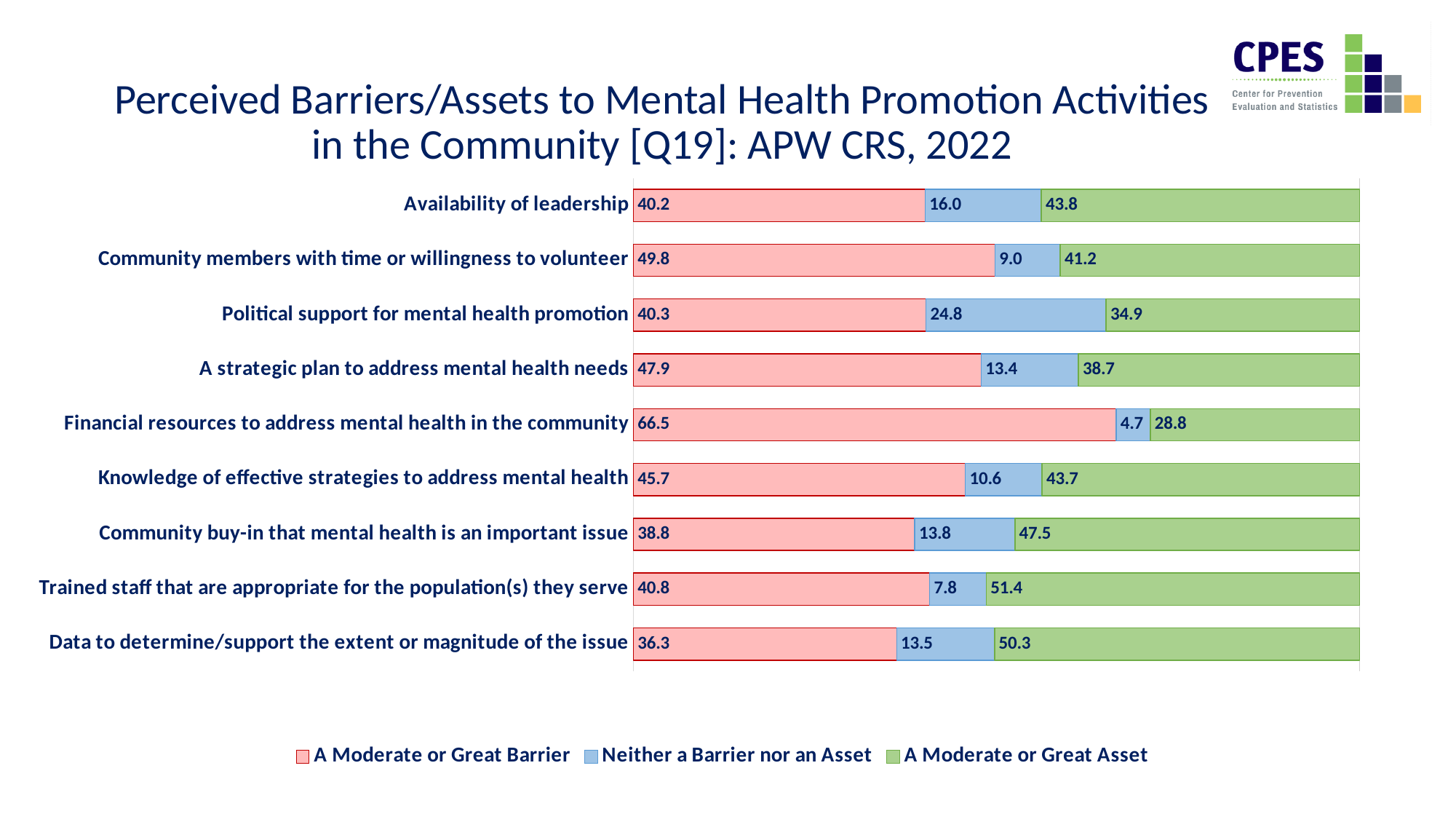
Which category has the lowest value for 'A Moderate or Great Barrier'? Data to determine/support the extent or magnitude of the issue How many series does the legend list? 3 Which category has the lowest value for 'Neither a Barrier nor an Asset'? Financial resources to address mental health in the community Which is larger: the 'A Moderate or Great Barrier' value for Community members with time or willingness to volunteer or for A strategic plan to address mental health needs? Community members with time or willingness to volunteer What is the value for 'Neither a Barrier nor an Asset' for Political support for mental health promotion? 24.8 Which category has the highest value for 'A Moderate or Great Barrier'? Financial resources to address mental health in the community What is the difference between the 'A Moderate or Great Asset' values for Trained staff that are appropriate for the population(s) they serve and Political support for mental health promotion? 16.5 What is the value for 'A Moderate or Great Asset' for Trained staff that are appropriate for the population(s) they serve? 51.4 What is the value for 'A Moderate or Great Barrier' for Financial resources to address mental health in the community? 66.5 How many categories are shown on the chart? 9 Which colour represents 'A Moderate or Great Asset' in the chart? Green What kind of chart is shown on the slide? Stacked bar chart